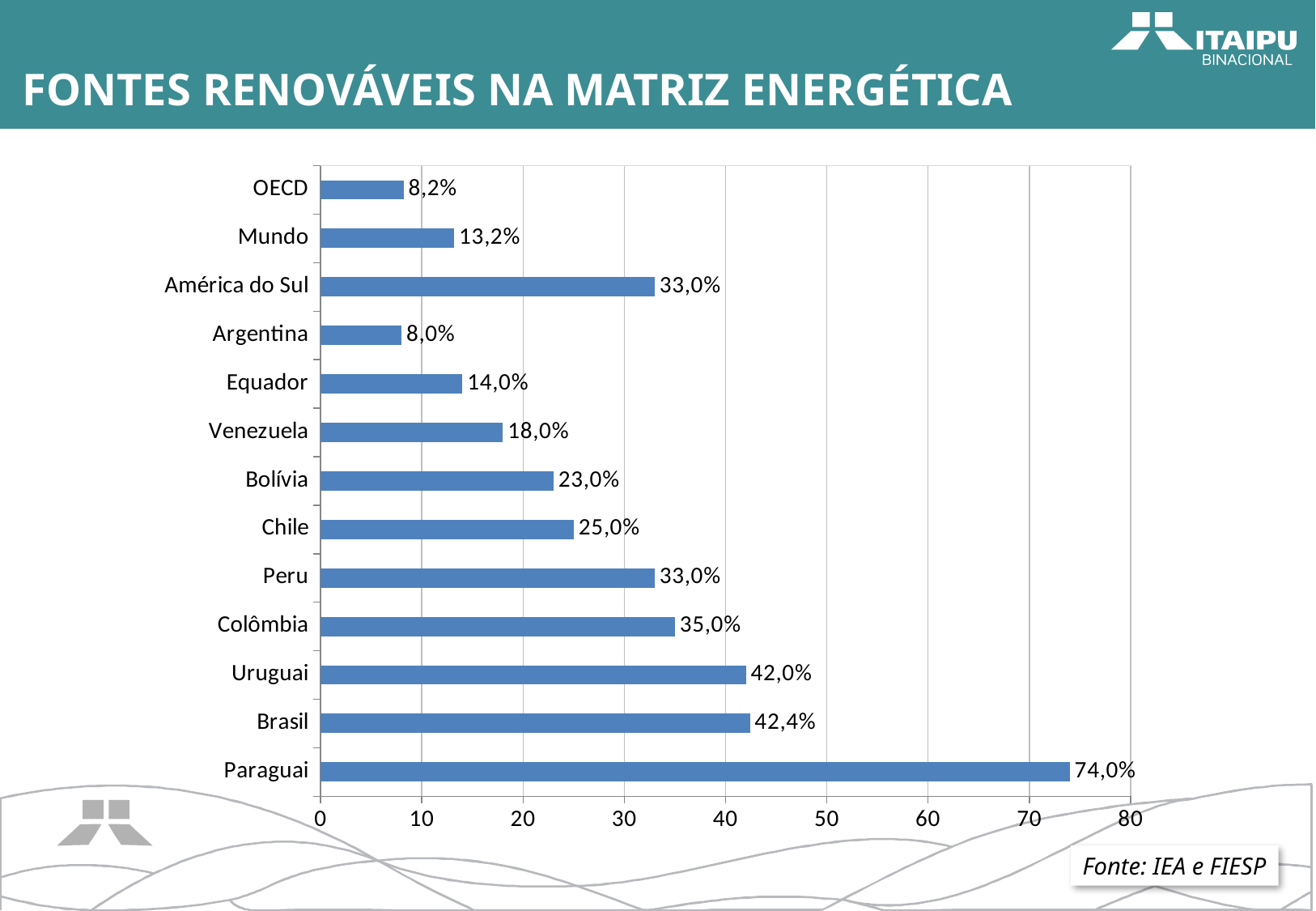
Which category has the highest value? Paraguai How many categories are shown in the chart? 13 What is the value shown for Venezuela? 18,0% Is the value for Venezuela greater or less than 20? less What is the value shown for Paraguai? 74,0% What is the value shown for Mundo? 13,2% What is the difference between the values for Paraguai and Brasil? 31,6% Which is larger, the value for Uruguai or the value for Bolívia? Uruguai What source is cited for the chart? IEA e FIESP What is the value shown for Brasil? 42,4% What kind of chart is shown on the slide? bar chart What is the difference between the values for Colômbia and Chile? 10,0%